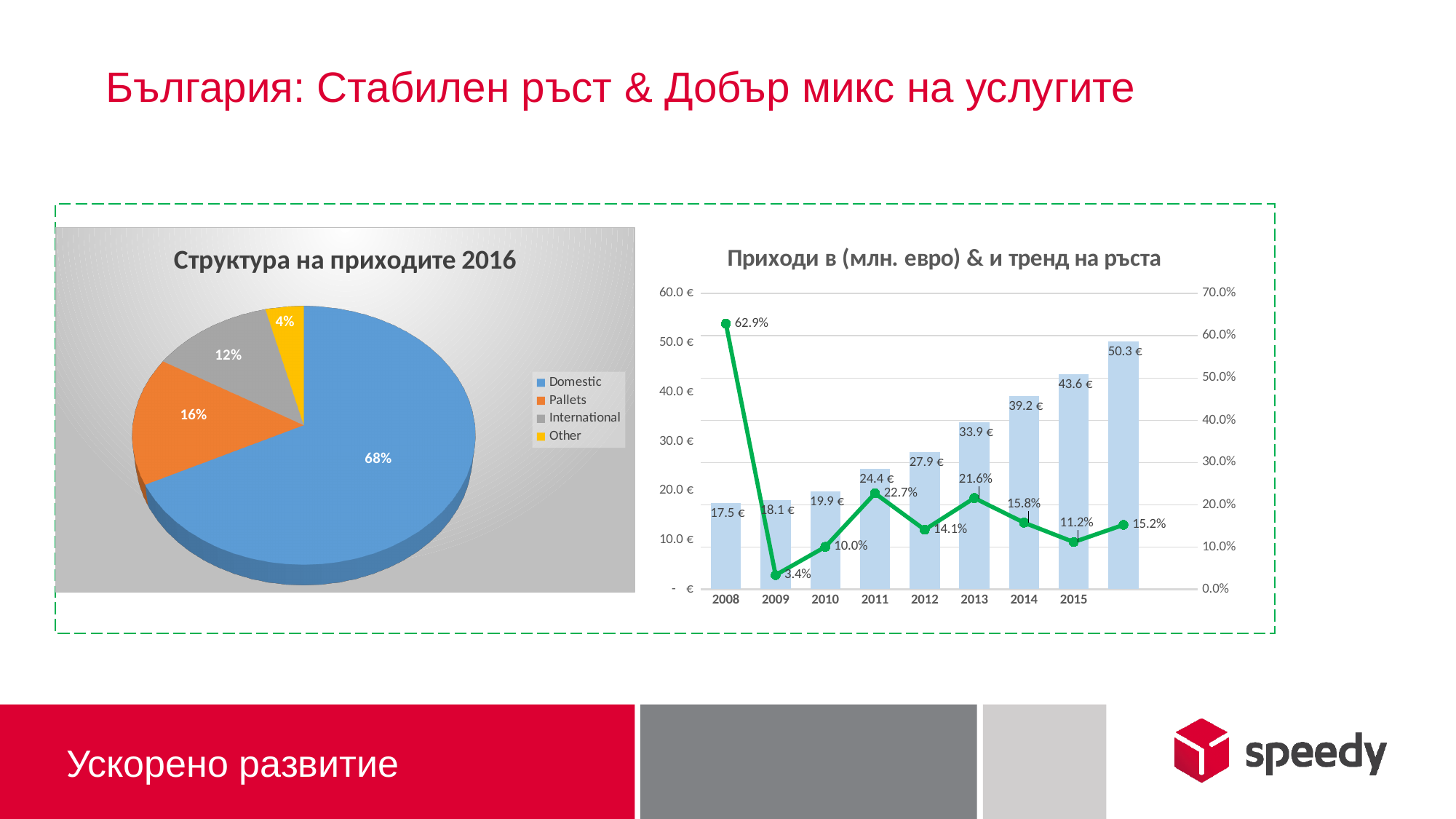
In the chart 'Приходи в (млн. евро) & и тренд на ръста', what is the revenue for 2011? 24.4 € In the pie chart 'Структура на приходите 2016', what share does Domestic have? 68% In the chart 'Приходи в (млн. евро) & и тренд на ръста', what is the growth rate for 2009? 3.4% In the pie chart 'Структура на приходите 2016', which category has the smallest share? Other In the pie chart 'Структура на приходите 2016', how many categories does the legend list? 4 In the chart 'Приходи в (млн. евро) & и тренд на ръста', which year has the highest growth rate? 2008 In the chart 'Приходи в (млн. евро) & и тренд на ръста', which year has the lowest revenue? 2008 In the chart 'Приходи в (млн. евро) & и тренд на ръста', what is the difference in revenue between 2015 and 2014? 4.4 € In the chart 'Приходи в (млн. евро) & и тренд на ръста', do the revenue bars rise or fall from 2008 to 2015? rise In the pie chart 'Структура на приходите 2016', what is the difference between the International and Other shares? 8% In the pie chart 'Структура на приходите 2016', what share does Pallets have? 16% In the chart 'Приходи в (млн. евро) & и тренд на ръста', is the growth rate higher in 2013 or in 2014? 2013